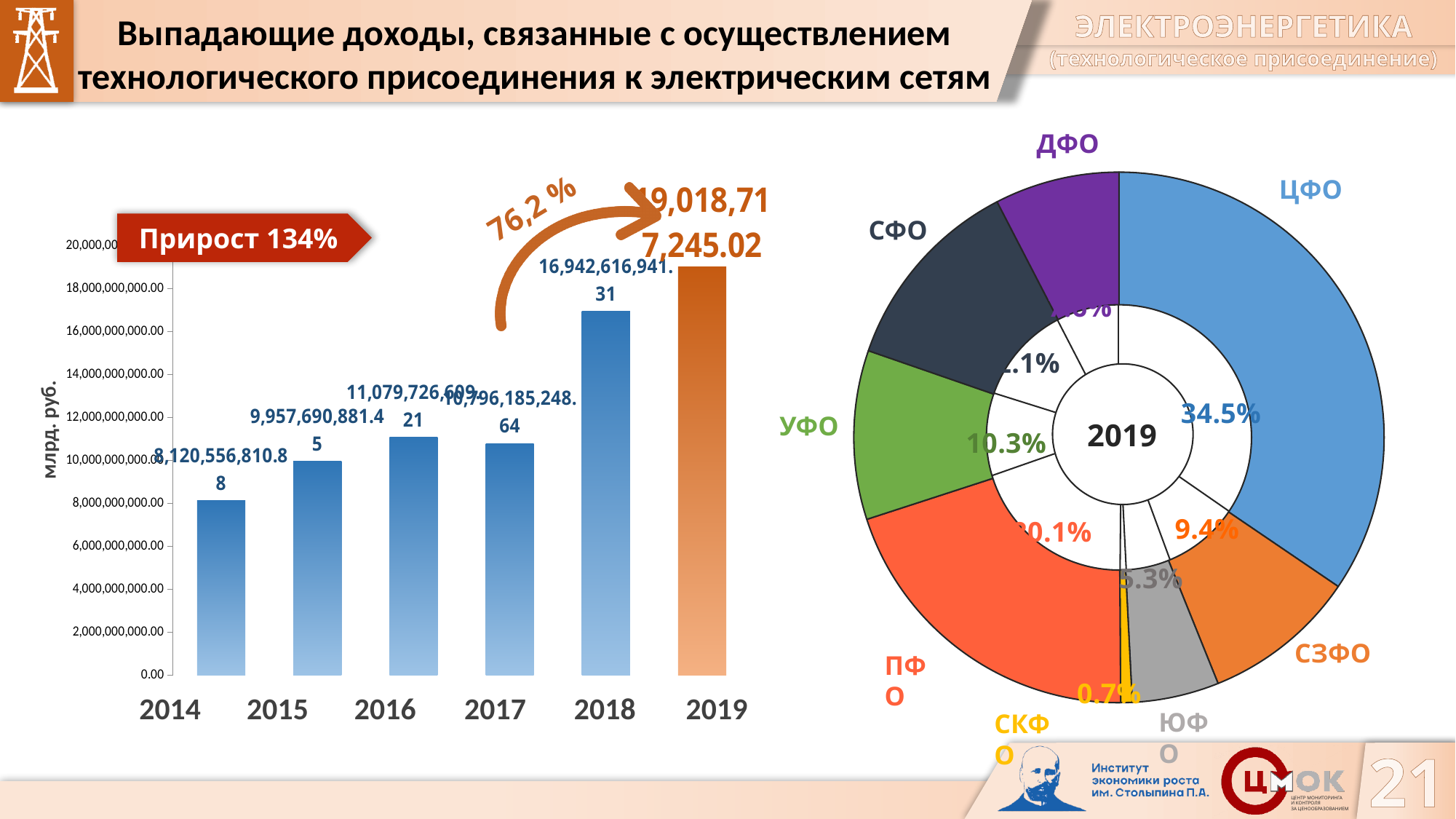
In the bar chart on the left, is the value for 2014 greater or less than 10,000,000,000.00? less In the bar chart on the left, how many years are shown on the x axis? 6 In the bar chart on the left, which year has the highest bar? 2019 In the pie chart on the right, what share does СЗФО have? 9.4% In the bar chart on the left, is the value for 2018 greater or less than 16,000,000,000.00? greater In the pie chart on the right, what share does ЦФО have? 34.5% What kind of chart is the chart on the right side of the slide? doughnut chart In the pie chart on the right, which district has the smallest slice? СКФО What percentage growth is shown in the red callout box on the bar chart? Прирост 134% What kind of chart is the chart on the left side of the slide? bar chart In the bar chart on the left, which year has the larger value, 2016 or 2017? 2016 In the bar chart on the left, which year has the lowest bar? 2014